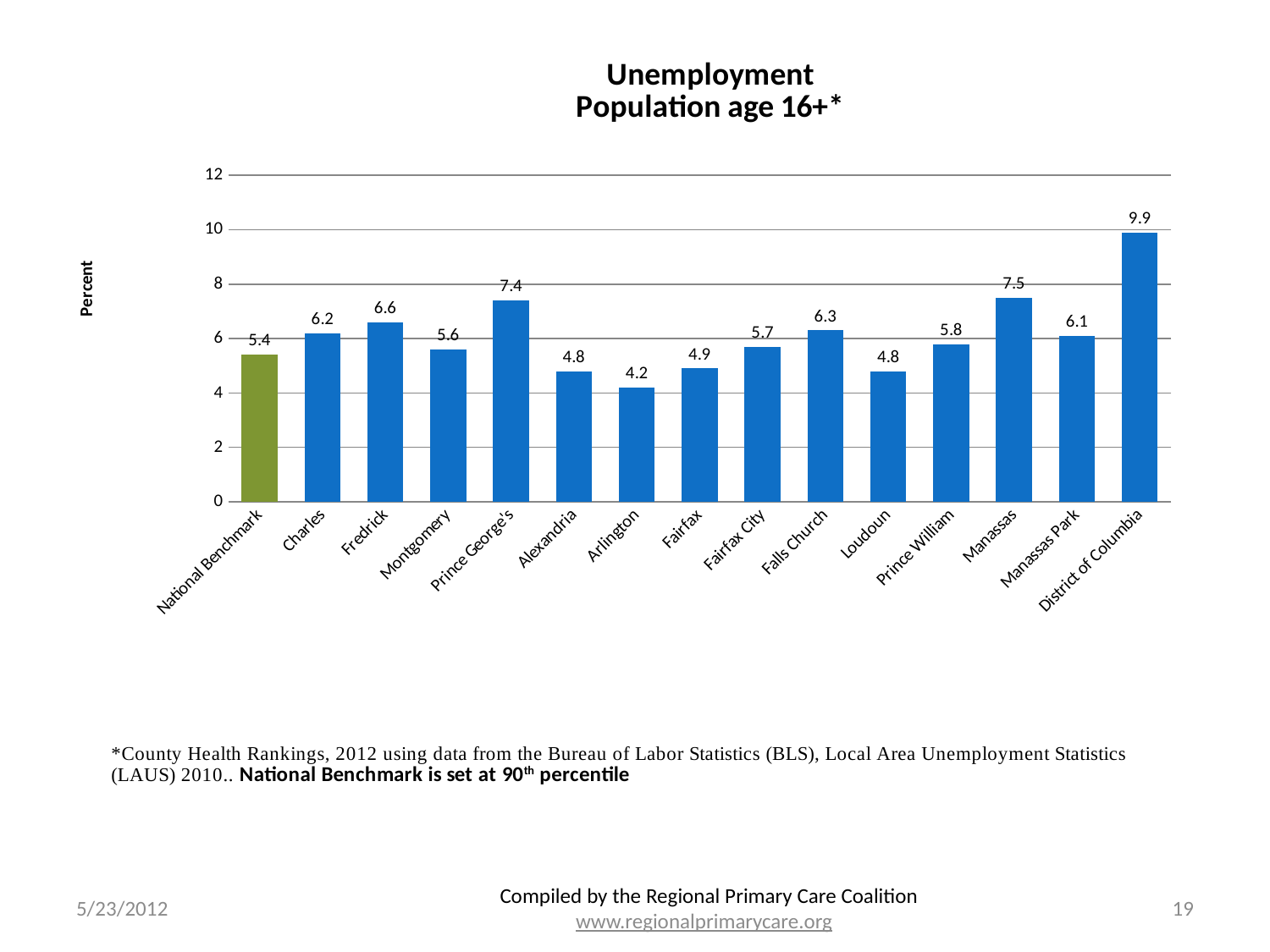
What kind of chart is shown on the slide? bar chart What is the difference between the unemployment rates of Manassas and Fairfax? 2.6 What is the value for the National Benchmark? 5.4 Which has a higher unemployment rate, Fredrick or Montgomery? Fredrick Is the value for Falls Church greater or less than 6? greater What is the unemployment rate for Prince George's? 7.4 Which category has the lowest unemployment rate? Arlington What is the unemployment rate for Manassas Park? 6.1 How many categories are shown on the x axis? 15 What is the label of the y axis? Percent Which category has the highest unemployment rate? District of Columbia What is the difference between the unemployment rates of District of Columbia and Arlington? 5.7